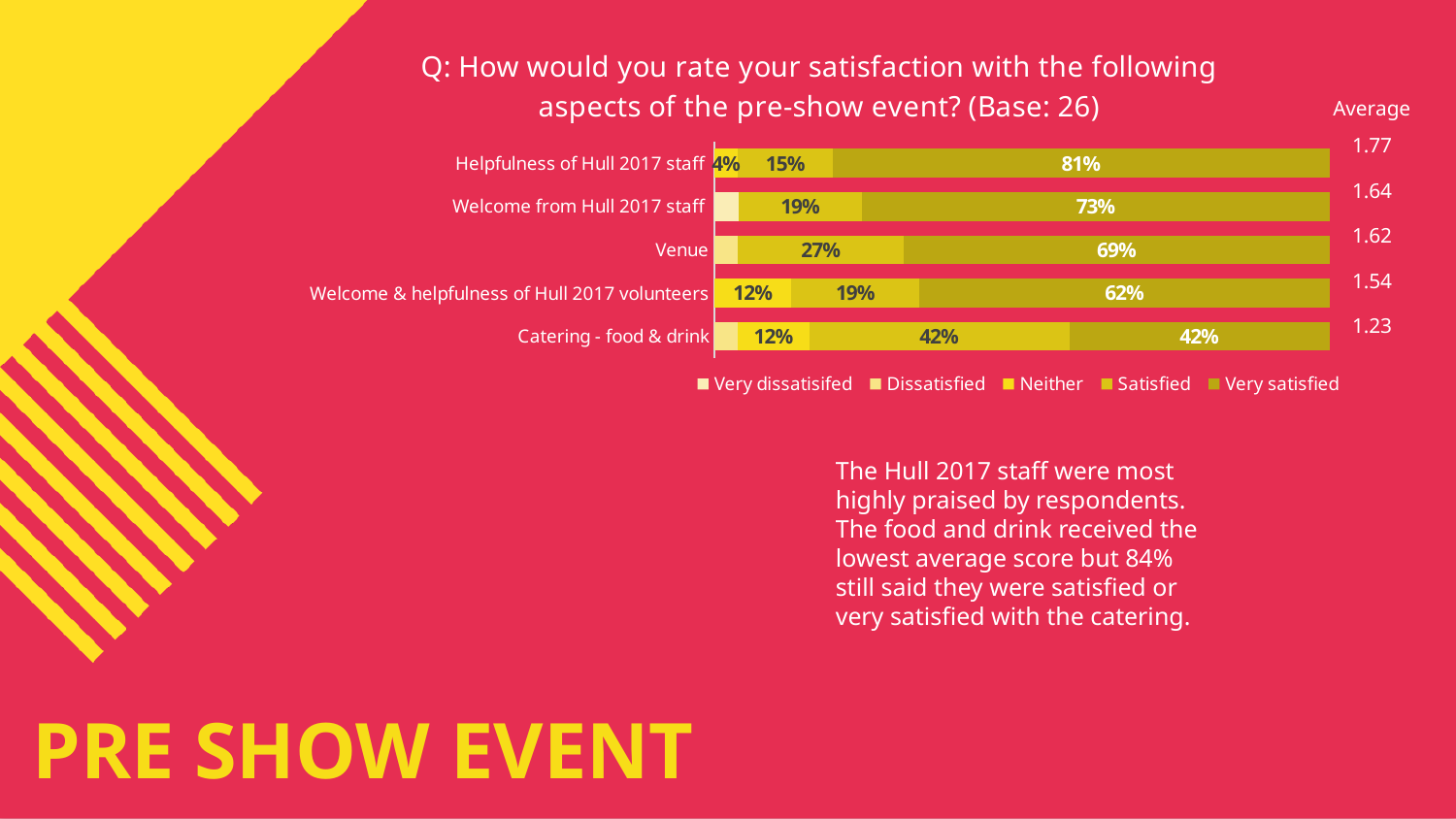
Which has a larger very satisfied percentage: Venue or Welcome & helpfulness of Hull 2017 volunteers? Venue Which aspect has the highest percentage of very satisfied respondents? Helpfulness of Hull 2017 staff How many aspects of the pre-show event are rated in the chart? 5 What is the average score shown for Helpfulness of Hull 2017 staff? 1.77 What is the average score shown for Catering - food & drink? 1.23 How many series does the legend list? 5 What percentage of respondents were very satisfied with the helpfulness of Hull 2017 staff? 81% What kind of chart is shown on the slide? Stacked bar chart Which aspect has the lowest average score? Catering - food & drink What is the base (number of respondents) stated in the chart title? 26 What is the difference between the very satisfied percentage for Helpfulness of Hull 2017 staff and for Welcome from Hull 2017 staff? 8% What percentage of respondents were satisfied (not very satisfied) with the venue? 27%